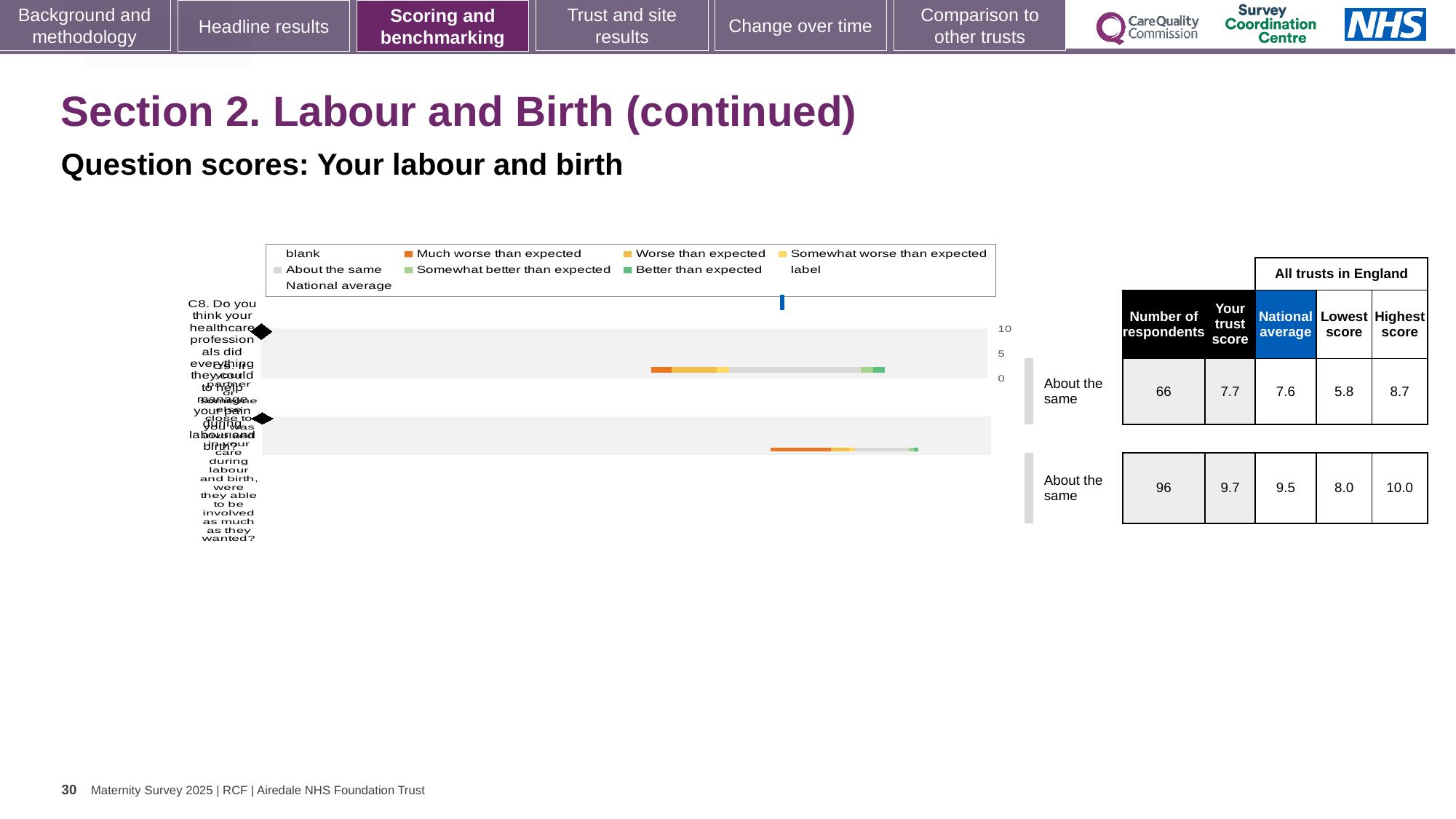
What is the trust's score for the second question in the table? 9.7 How many respondents are listed for the second question in the table? 96 What is the trust's score for question C8 (the first row of the table)? 7.7 How many respondents answered question C8 according to the table? 66 What kind of chart is used to show the question scores on this slide? Bar chart For question C8, which is larger: the trust's score or the national average? The trust's score (7.7) What is the national average for question C8 (the first row of the table)? 7.6 For the second question in the table, what is the difference between the highest score (10.0) and the lowest score (8.0)? 2.0 What is the lowest score among all trusts in England for question C8 (the first row)? 5.8 For question C8, what is the difference between the highest score and the lowest score across all trusts in England? 2.9 What is the highest score among all trusts in England for question C8 (the first row)? 8.7 What benchmark category is shown for question C8 next to the chart? About the same